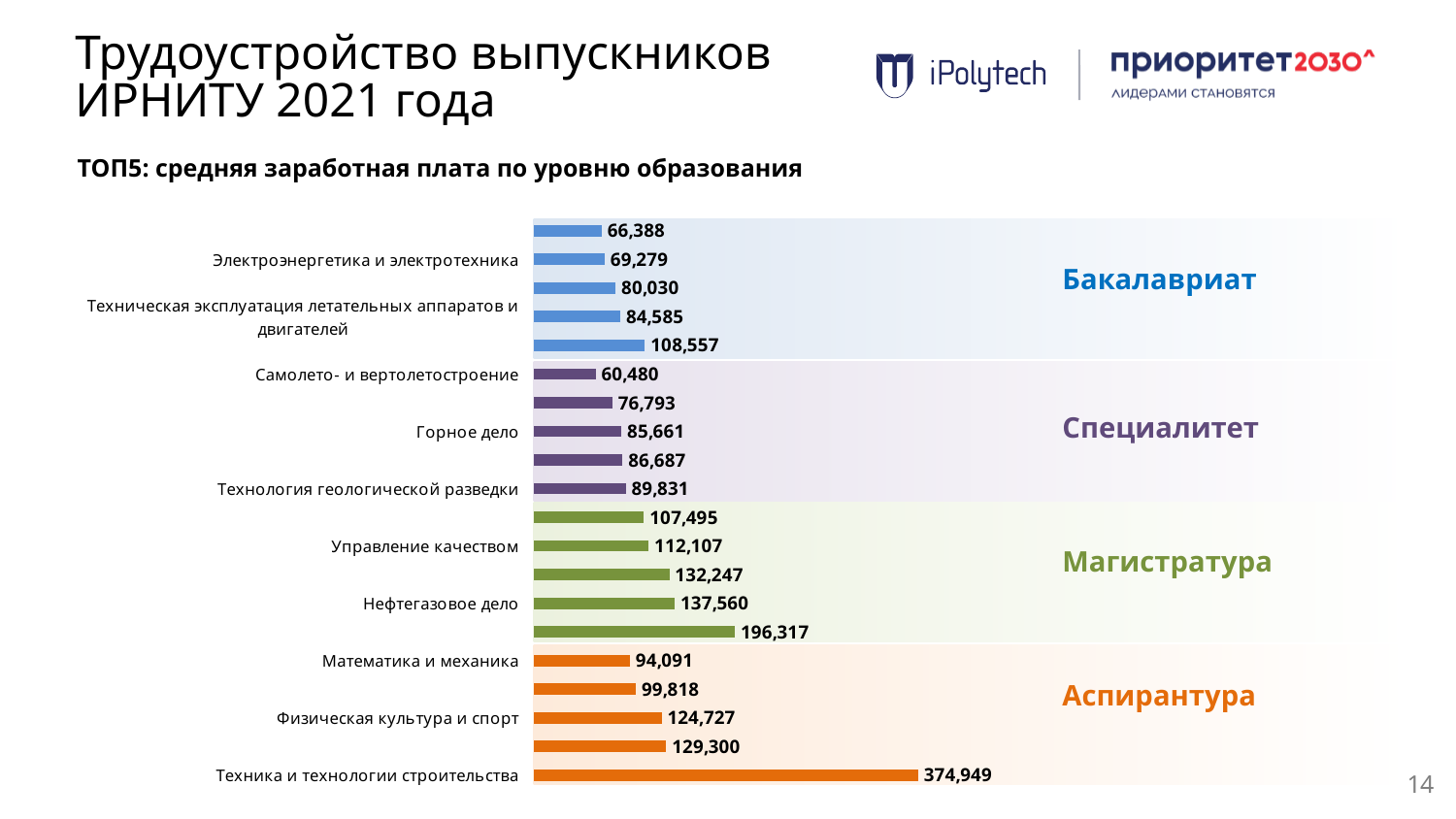
What kind of chart is shown on the slide? bar chart What is the value shown for Техника и технологии строительства? 374,949 What is the lowest value shown in the Специалитет group? 60,480 What is the highest value shown in the Магистратура group? 196,317 What is the difference between the value for Техника и технологии строительства and the value for Физическая культура и спорт? 250,222 Which is larger, the value for Горное дело or the value for Нефтегазовое дело? Нефтегазовое дело How many bars are plotted on the chart in total? 20 What is the value shown for Самолето- и вертолетостроение? 60,480 What is the value shown for Нефтегазовое дело? 137,560 What is the value shown for Физическая культура и спорт? 124,727 Which bar has the highest value on the whole chart? Техника и технологии строительства (374,949) What is the value shown for Горное дело? 85,661